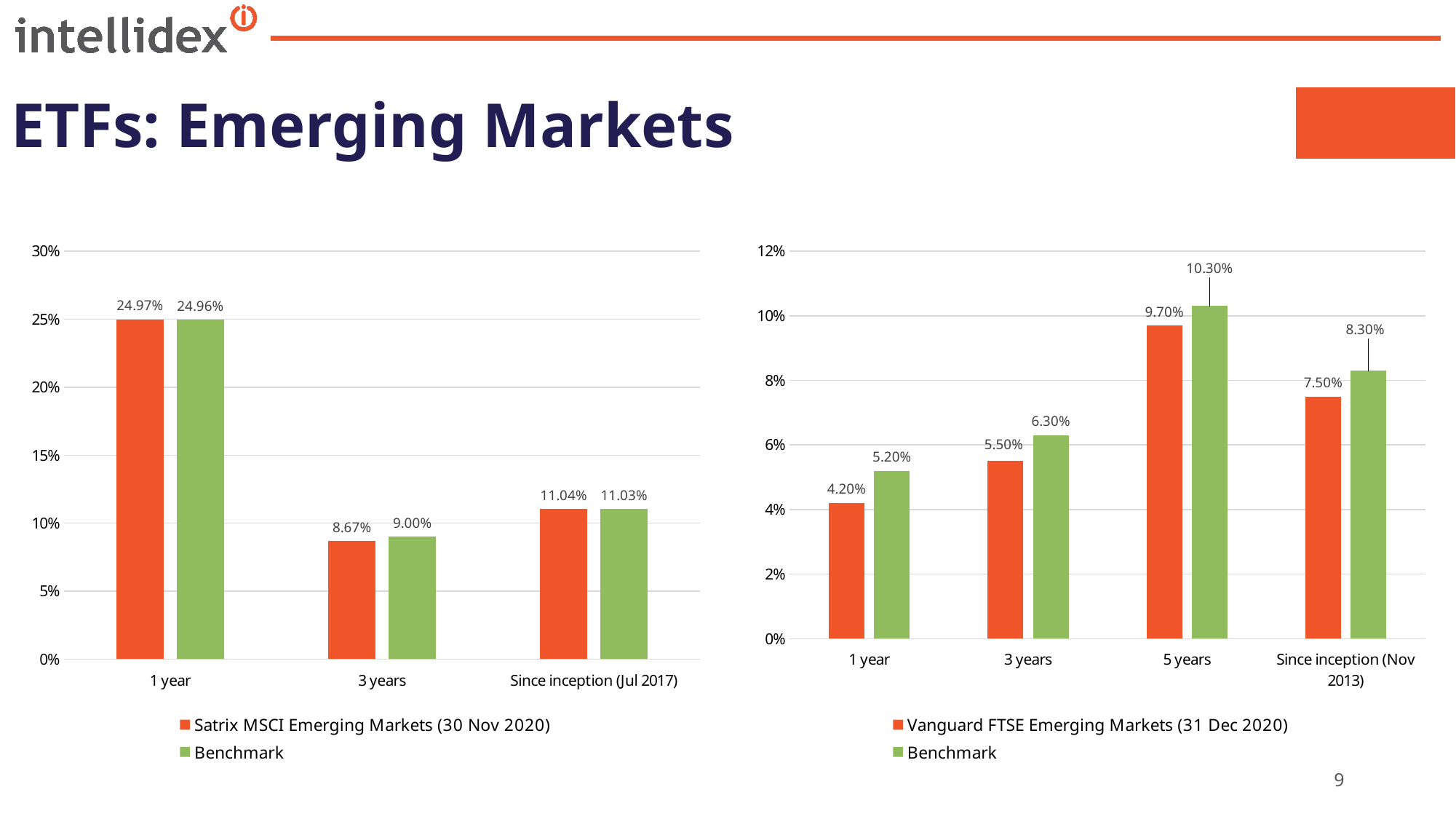
In the right chart (Vanguard FTSE Emerging Markets), what is the Vanguard value for Since inception (Nov 2013)? 7.50% In the right chart (Vanguard FTSE Emerging Markets), what is the difference between the Benchmark and Vanguard values for 1 year? 1.00% In the left chart (Satrix MSCI Emerging Markets), what is the Benchmark value for 3 years? 9.00% In the left chart (Satrix MSCI Emerging Markets), what is the 1 year value for Satrix MSCI Emerging Markets (30 Nov 2020)? 24.97% In the right chart (Vanguard FTSE Emerging Markets), what is the Benchmark value for 5 years? 10.30% In the right chart (Vanguard FTSE Emerging Markets), is the Vanguard value for 3 years larger or smaller than the Benchmark value for 3 years? smaller In the right chart (Vanguard FTSE Emerging Markets), how many series does the legend list? 2 In the left chart (Satrix MSCI Emerging Markets), what is the Satrix value for Since inception (Jul 2017)? 11.04% In the left chart (Satrix MSCI Emerging Markets), which period has the highest Satrix value? 1 year In the right chart (Vanguard FTSE Emerging Markets), which period has the lowest Vanguard value? 1 year In the left chart (Satrix MSCI Emerging Markets), how many periods are shown on the x axis? 3 In the left chart (Satrix MSCI Emerging Markets), what is the difference between the Benchmark and Satrix values for 3 years? 0.33%